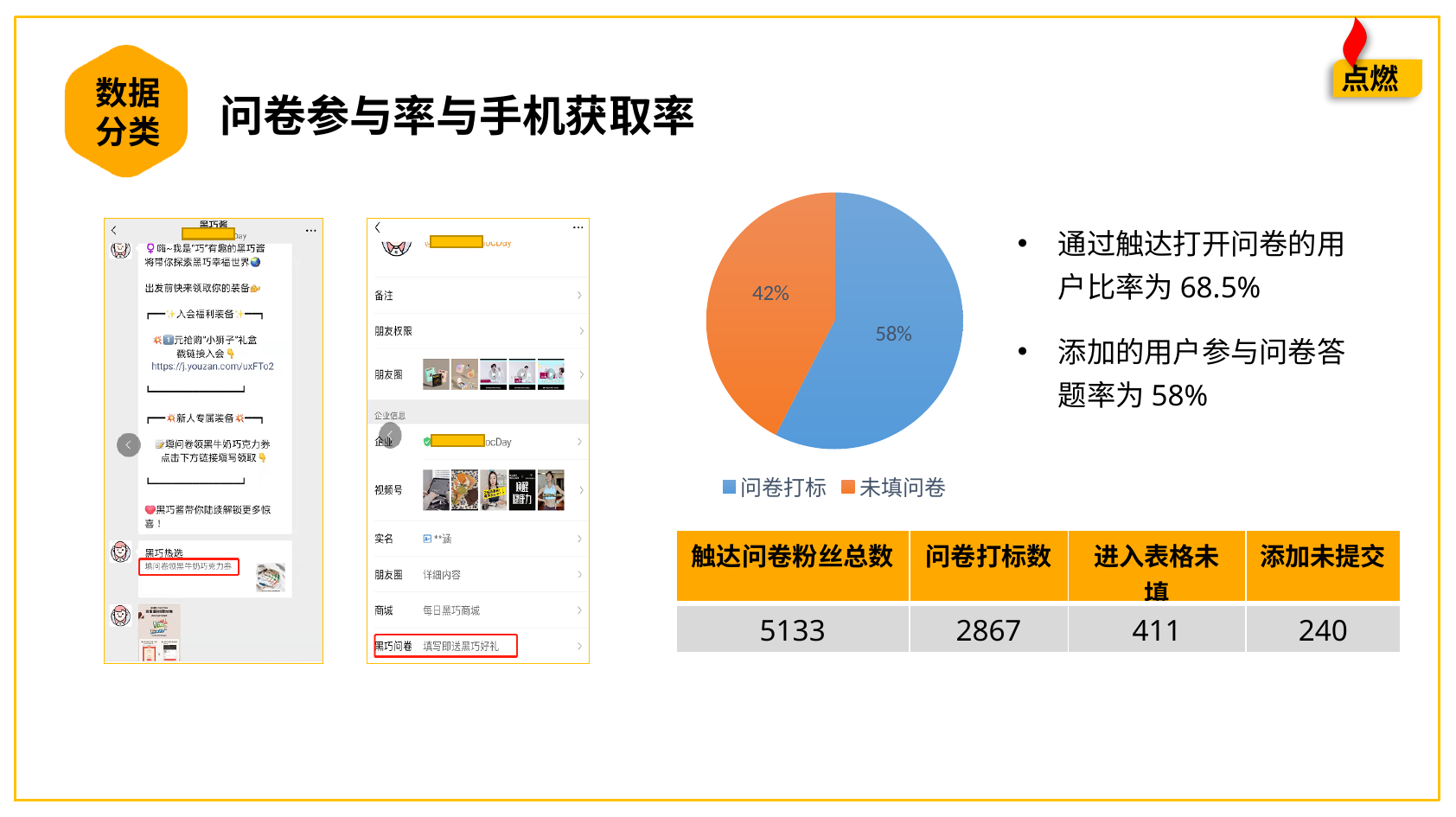
What share of the pie does 问卷打标 represent? 58% What is the difference in percentage points between the 问卷打标 and 未填问卷 slices? 16% What colour is the 问卷打标 slice in the pie chart? blue What share of the pie does 未填问卷 represent? 42% How many entries does the pie chart's legend list? 2 Is the share for 未填问卷 greater or less than 50%? less What kind of chart is shown on the slide? pie chart How many slices does the pie chart have? 2 What colour is the 未填问卷 slice in the pie chart? orange Which slice of the pie chart is the smallest? 未填问卷 Which slice of the pie chart is the largest? 问卷打标 Which is larger in the pie chart, 问卷打标 or 未填问卷? 问卷打标